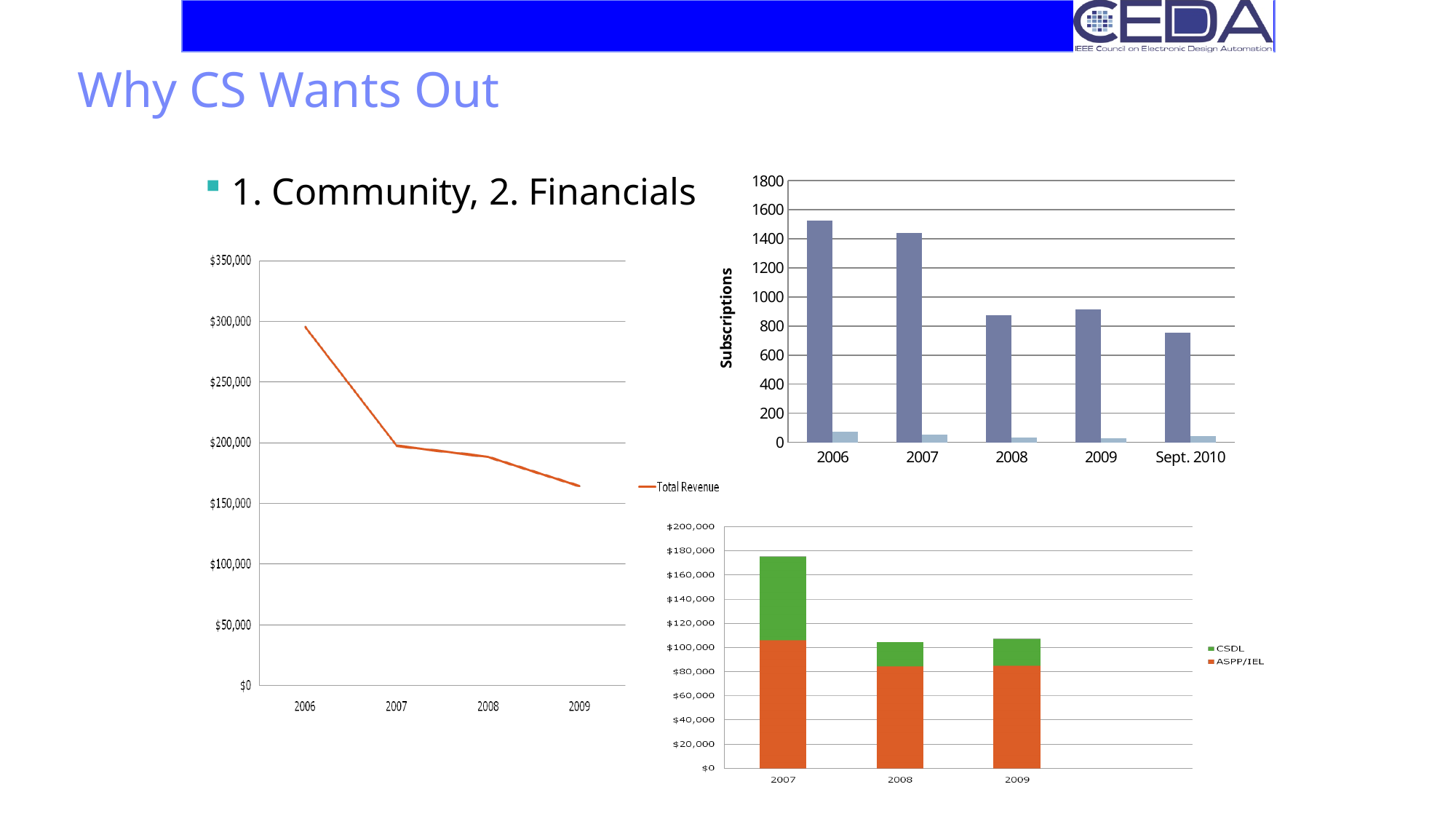
In the left line chart, which year has the highest Total Revenue? 2006 In the bottom-right stacked bar chart, which year has the highest total bar? 2007 In the left line chart, is the Total Revenue for 2009 greater or less than $200,000? less In the left line chart, is the Total Revenue for 2006 greater or less than $250,000? greater In the top-right Subscriptions chart, which category has the highest value for the tall dark-blue bars? 2006 What kind of chart is the top-right chart with the Subscriptions axis? bar chart What kind of chart is the chart on the left of the slide? line chart In the left line chart, what is the name of the series shown in the legend? Total Revenue In the top-right Subscriptions chart, is the dark-blue bar for 2008 greater or less than 1000? less In the top-right Subscriptions chart, how many categories are shown on the x axis? 5 In the bottom-right stacked bar chart, how many series does the legend list? 2 In the left line chart, does Total Revenue rise or fall from 2006 to 2009? fall